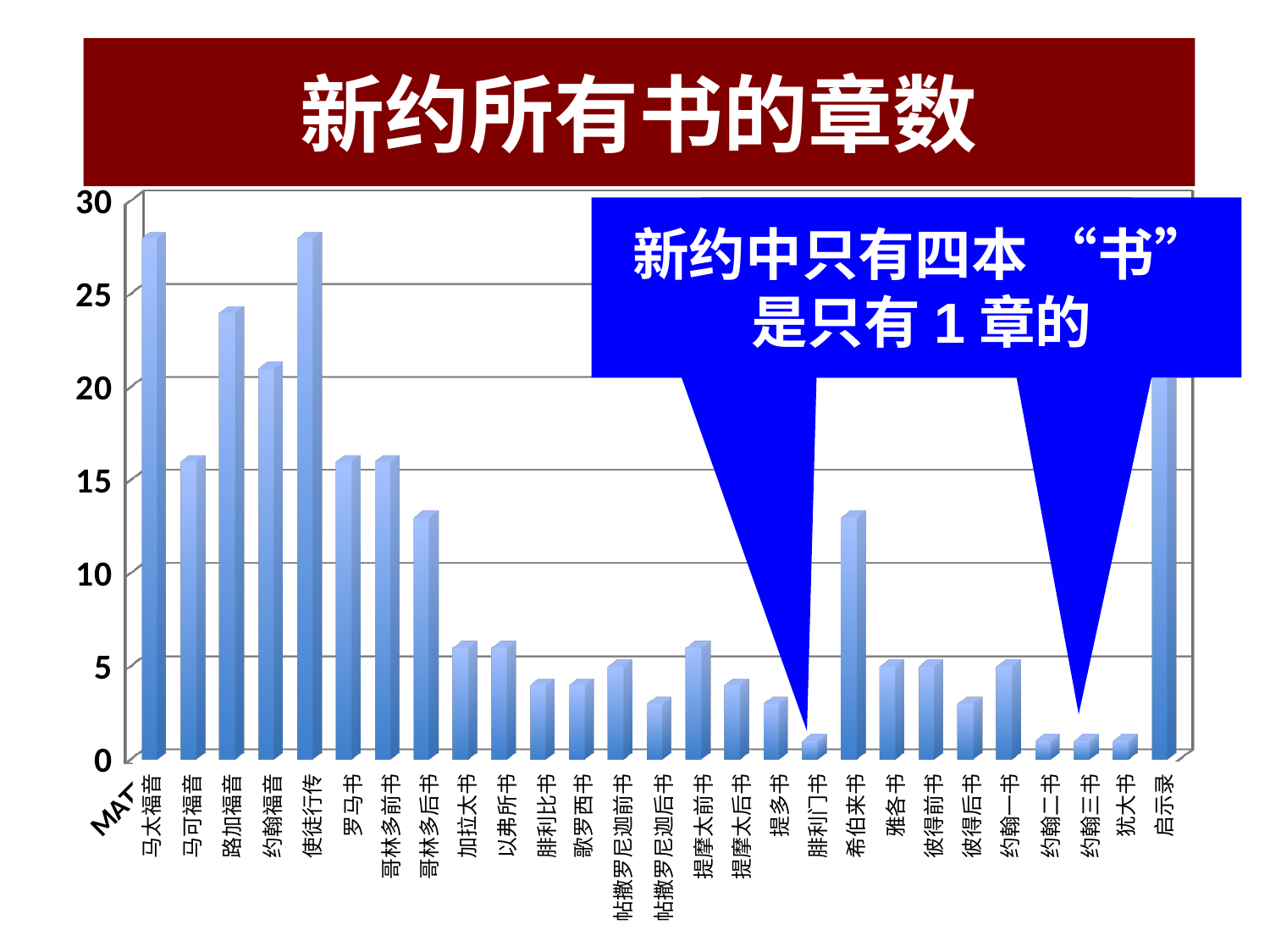
Is the value for 希伯来书 greater or less than 10? greater Is the value for 腓利门书 greater or less than 5? less What is the title of the chart? 新约所有书的章数 Is the value for 哥林多后书 greater or less than 10? greater What value does the bar for 雅各书 reach on the axis? 5 What kind of chart is shown on the slide? bar chart Which has the larger value, 路加福音 or 约翰福音? 路加福音 According to the callout on the chart, how many books in the New Testament have only 1 chapter? 四本 Which has the larger value, 马太福音 or 马可福音? 马太福音 How many bars (books) are plotted in the chart? 27